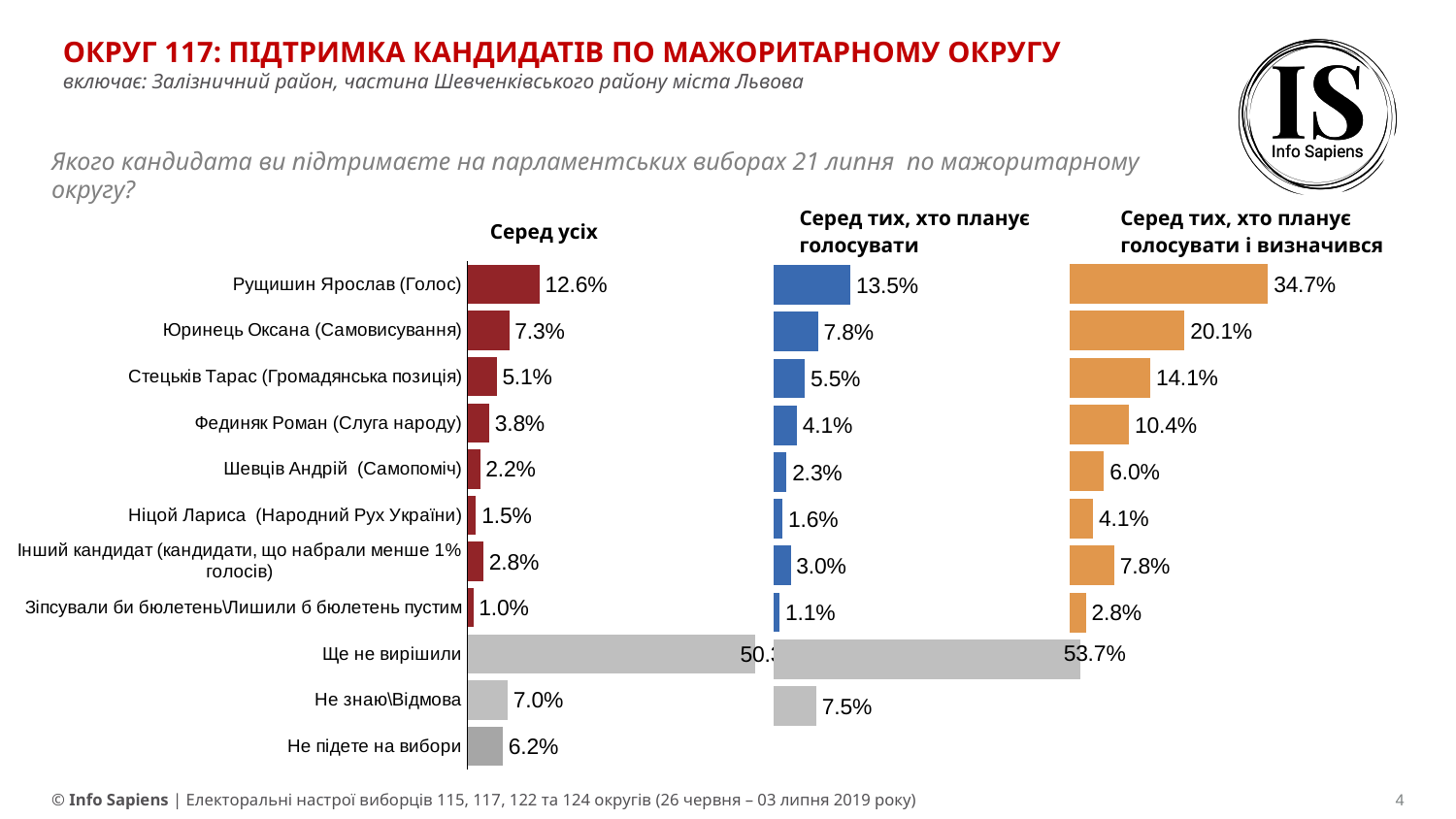
In the 'Серед усіх' chart, what is the value for Рущишин Ярослав (Голос)? 12.6% In the 'Серед тих, хто планує голосувати і визначився' chart, what is the difference between Рущишин Ярослав (Голос) and Юринець Оксана (Самовисування)? 14.6% In the 'Серед усіх' chart, what is the value for Не підете на вибори? 6.2% What colour are the bars for candidates in the 'Серед тих, хто планує голосувати і визначився' chart? Orange In the 'Серед тих, хто планує голосувати і визначився' chart, what is the value for Юринець Оксана (Самовисування)? 20.1% In the 'Серед усіх' chart, which category has the lowest value? Зіпсували би бюлетень\Лишили б бюлетень пустим In the 'Серед тих, хто планує голосувати' chart, what is the value for Ще не вирішили? 53.7% How many categories are shown in the 'Серед усіх' chart? 11 What type of chart is used on this slide? Bar chart How many categories are shown in the 'Серед тих, хто планує голосувати і визначився' chart? 8 In the 'Серед тих, хто планує голосувати' chart, which is larger: Стецьків Тарас (Громадянська позиція) or Фединяк Роман (Слуга народу)? Стецьків Тарас (Громадянська позиція) In the 'Серед тих, хто планує голосувати і визначився' chart, which candidate has the highest value? Рущишин Ярослав (Голос)